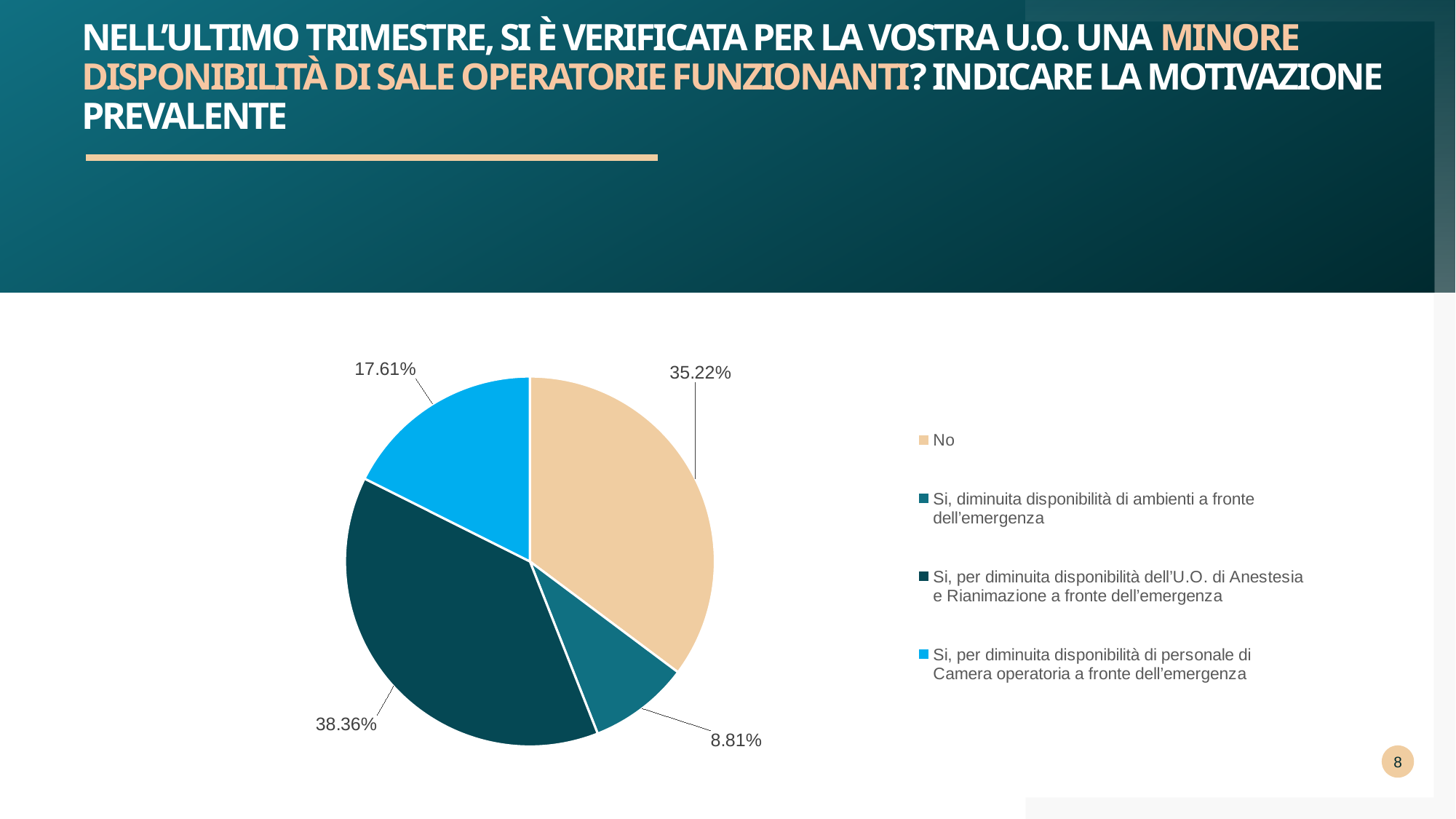
What is the difference in percentage points between the "No" slice and the "Si, per diminuita disponibilità di personale di Camera operatoria a fronte dell'emergenza" slice? 17.61 Which is larger: the share for "No" or the share for "Si, per diminuita disponibilità dell'U.O. di Anestesia e Rianimazione a fronte dell'emergenza"? Si, per diminuita disponibilità dell'U.O. di Anestesia e Rianimazione a fronte dell'emergenza Which category has the largest share of the pie? Si, per diminuita disponibilità dell'U.O. di Anestesia e Rianimazione a fronte dell'emergenza How many slices does the pie chart have? 4 How many entries does the legend list? 4 Which category has the smallest share of the pie? Si, diminuita disponibilità di ambienti a fronte dell'emergenza What percentage is shown for "Si, diminuita disponibilità di ambienti a fronte dell'emergenza"? 8.81% What percentage of the pie corresponds to "No"? 35.22% What percentage is shown for "Si, per diminuita disponibilità di personale di Camera operatoria a fronte dell'emergenza"? 17.61% What kind of chart is shown on the slide? Pie chart What percentage is shown for "Si, per diminuita disponibilità dell'U.O. di Anestesia e Rianimazione a fronte dell'emergenza"? 38.36% What colour is the slice representing "No"? Tan (beige)